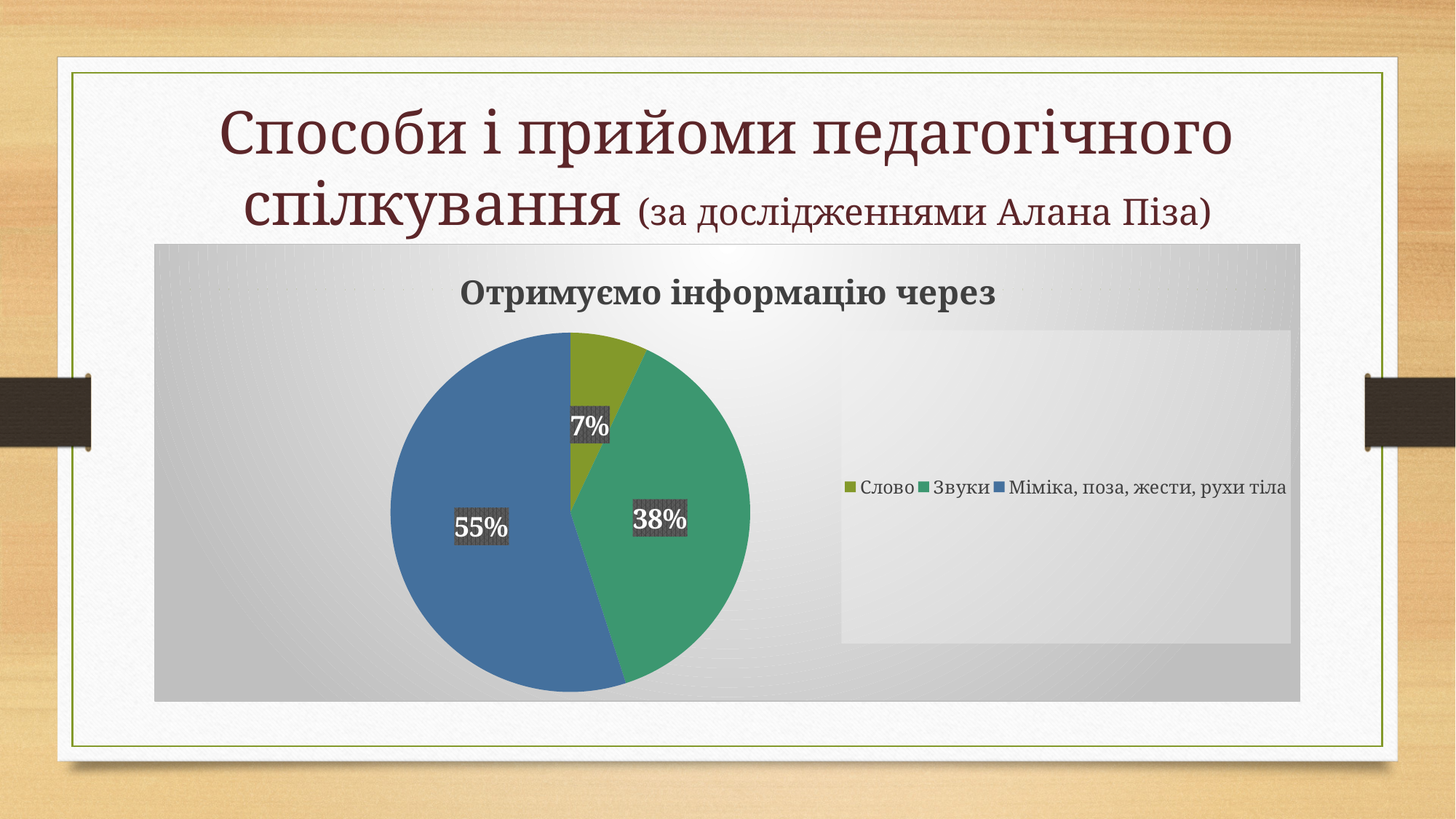
Which category has the largest slice of the pie? Міміка, поза, жести, рухи тіла How many categories does the pie chart have? 3 Which is larger, the slice for "Звуки" or the slice for "Слово"? Звуки What share of the pie does "Звуки" represent? 38% What colour is the slice for "Слово"? green (olive) What is the title of the chart? Отримуємо інформацію через What is the difference in percentage points between "Міміка, поза, жести, рухи тіла" and "Звуки"? 17 What is the difference in percentage points between "Звуки" and "Слово"? 31 What share of the pie does "Міміка, поза, жести, рухи тіла" represent? 55% What type of chart is shown on the slide? pie chart Which category has the smallest slice of the pie? Слово What share of the pie does "Слово" represent? 7%